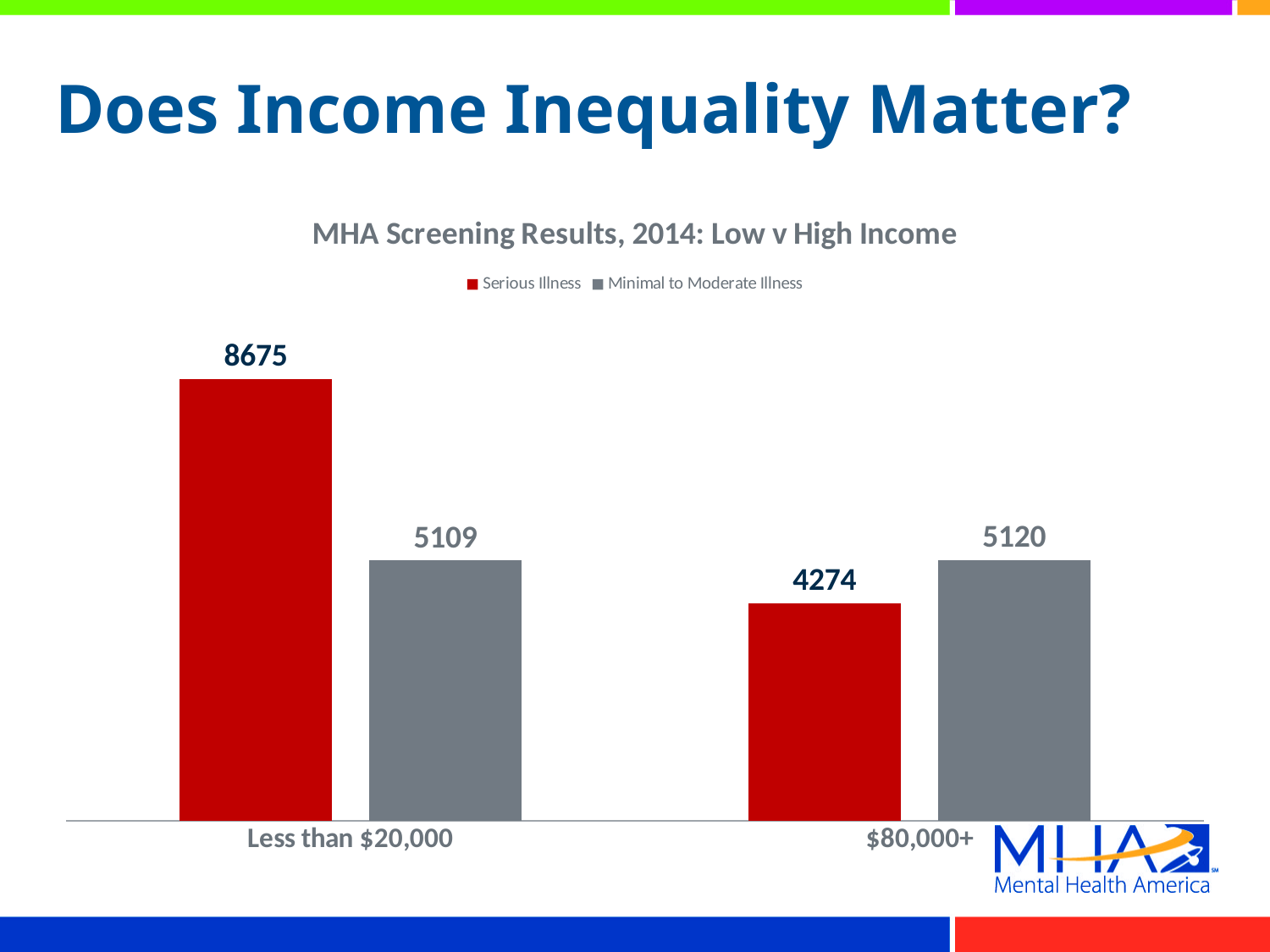
How many series does the legend list? 2 What is the difference between the Serious Illness values for Less than $20,000 and $80,000+? 4401 What is the Serious Illness value for the Less than $20,000 income group? 8675 What is the title of the chart? MHA Screening Results, 2014: Low v High Income For the Less than $20,000 group, which is larger: Serious Illness or Minimal to Moderate Illness? Serious Illness What is the Serious Illness value for the $80,000+ income group? 4274 What is the Minimal to Moderate Illness value for the $80,000+ income group? 5120 How many income categories are shown on the x axis? 2 Which income group has the highest Serious Illness value? Less than $20,000 What is the Minimal to Moderate Illness value for the Less than $20,000 income group? 5109 Which bar on the chart has the lowest value? Serious Illness for $80,000+ What kind of chart is shown on the slide? Bar chart